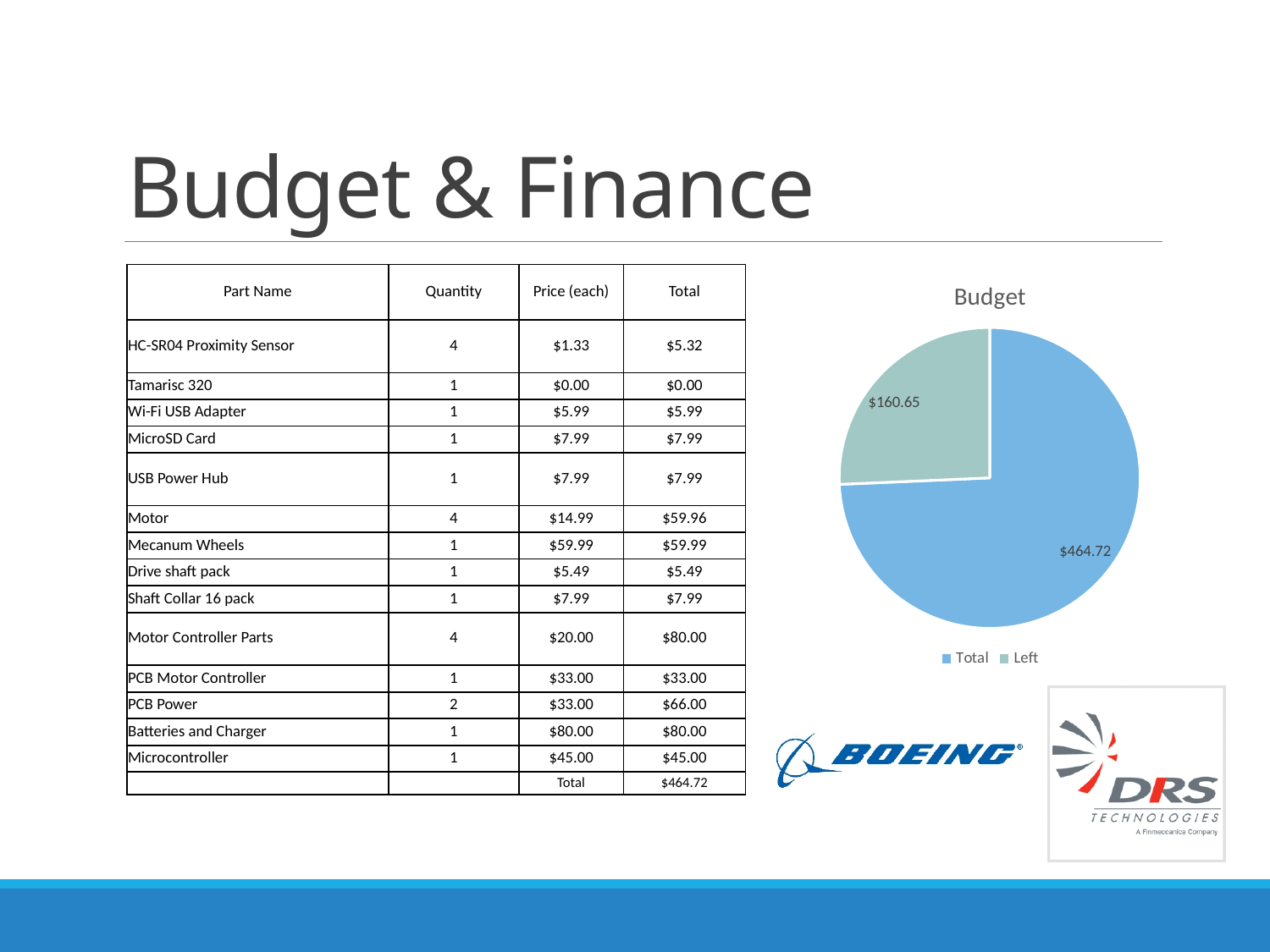
What is the title of the chart? Budget What is the difference between the Total slice and the Left slice in the pie chart? $304.07 What value is shown for the Total slice of the pie chart? $464.72 Which slice of the pie chart is the smallest? Left How many entries does the chart legend list? 2 Which is larger in the pie chart, Total or Left? Total What is the sum of the two slices shown in the pie chart? $625.37 How many slices does the pie chart have? 2 Which slice of the pie chart is the largest? Total What kind of chart is shown on the slide? pie chart What colour is the Total slice in the pie chart? blue What value is shown for the Left slice of the pie chart? $160.65